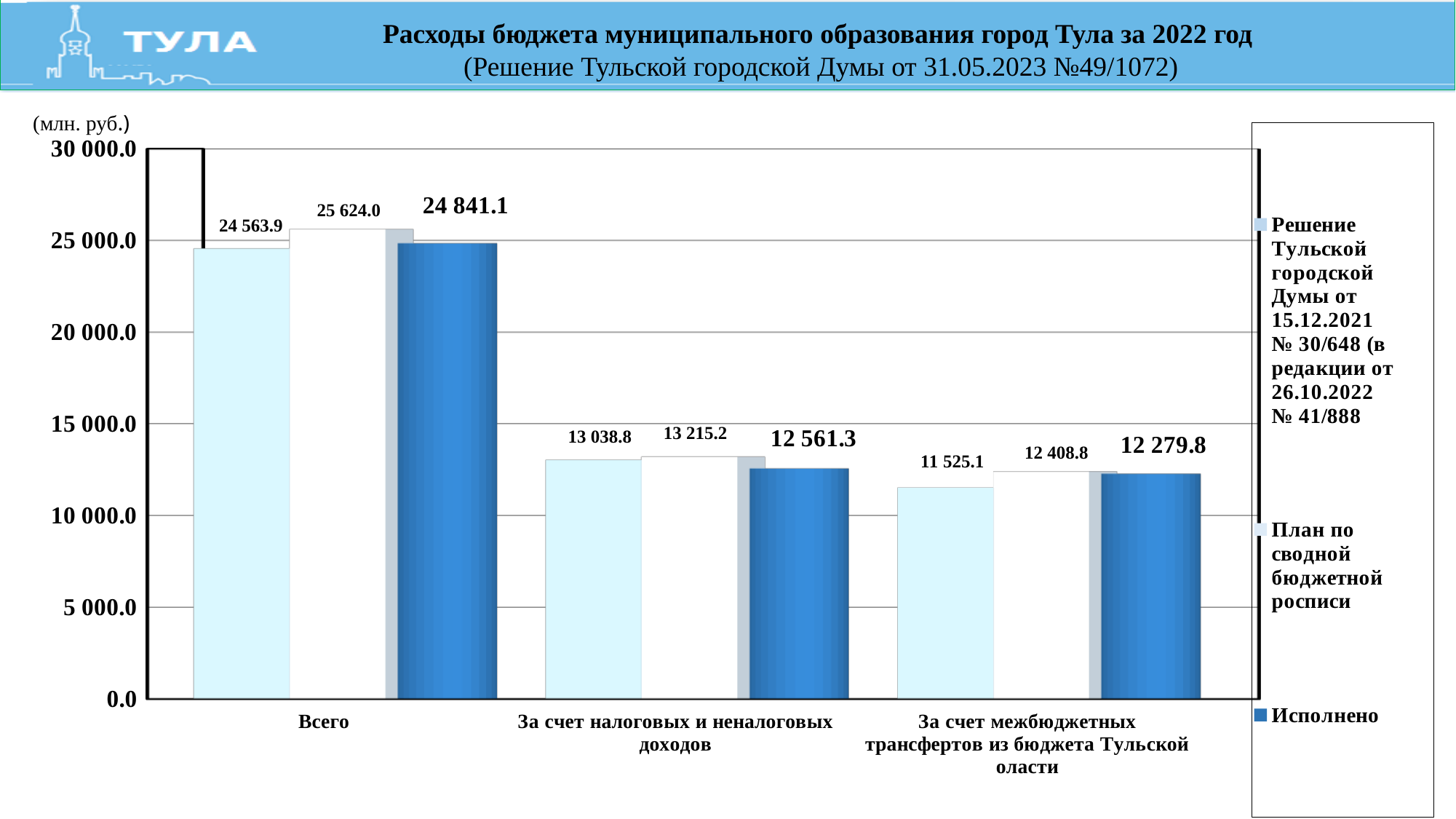
What is the value of "Исполнено" for "За счет межбюджетных трансфертов из бюджета Тульской оласти"? 12 279.8 Which category has the highest "Исполнено" value? Всего What is the value of the "Решение Тульской городской Думы" series for "За счет межбюджетных трансфертов из бюджета Тульской оласти"? 11 525.1 For the category "Всего", which is larger: "План по сводной бюджетной росписи" or "Исполнено"? План по сводной бюджетной росписи How many series does the legend list? 3 What is the difference between "План по сводной бюджетной росписи" and "Исполнено" for "За счет налоговых и неналоговых доходов"? 653.9 What is the value of "План по сводной бюджетной росписи" for "За счет налоговых и неналоговых доходов"? 13 215.2 What is the difference between "План по сводной бюджетной росписи" and "Исполнено" for the category "Всего"? 782.9 Which category has the lowest value in the "Решение Тульской городской Думы" series? За счет межбюджетных трансфертов из бюджета Тульской оласти What type of chart is shown on the slide? Bar chart How many categories are shown on the x axis of the chart? 3 What is the value of "Исполнено" for the category "Всего"? 24 841.1